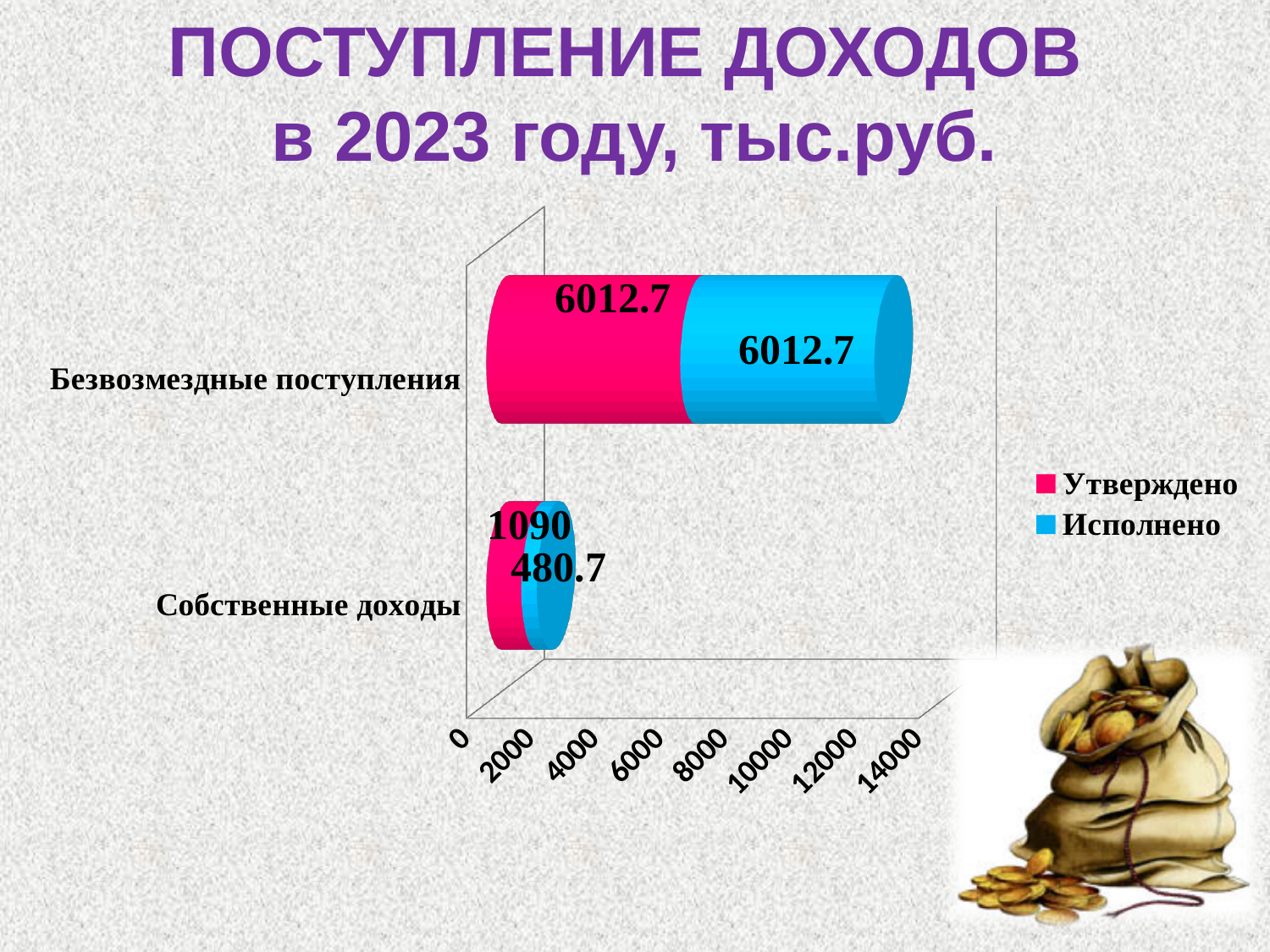
What is the Исполнено value for Собственные доходы? 480.7 For Собственные доходы, which is larger: Утверждено or Исполнено? Утверждено What is the total of the stacked bar for Безвозмездные поступления? 12025.4 Which category has the higher Утверждено value? Безвозмездные поступления What is the total of the stacked bar for Собственные доходы? 1570.7 What is the Утверждено value for Собственные доходы? 1090 How many series does the legend list? 2 Which category has the lowest Исполнено value? Собственные доходы What is the Утверждено value for Безвозмездные поступления? 6012.7 What kind of chart is shown on the slide? Bar chart What is the difference between the Утверждено and Исполнено values for Собственные доходы? 609.3 What is the Исполнено value for Безвозмездные поступления? 6012.7